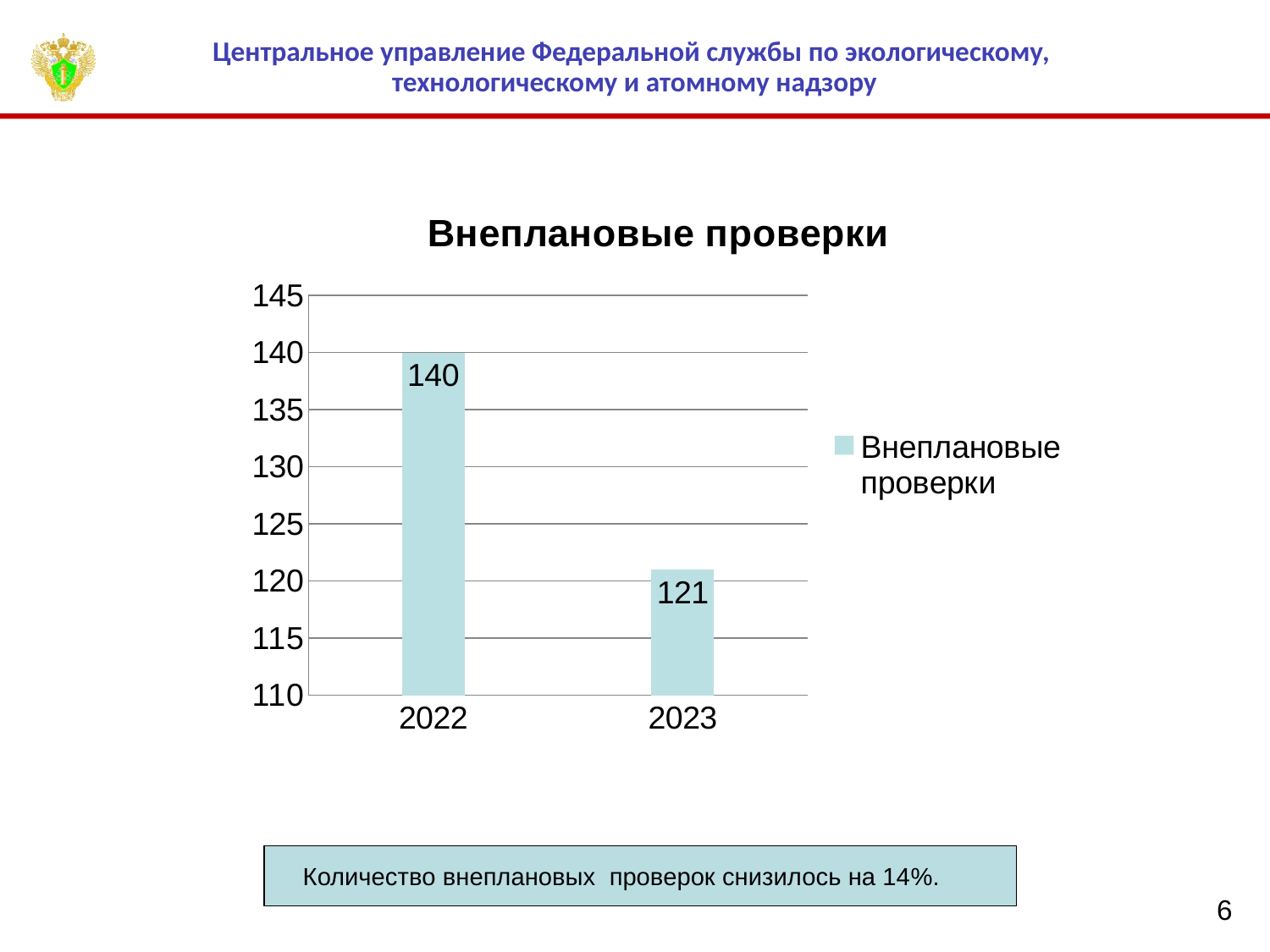
What is the value for 2023? 121 What is the difference between the values for 2022 and 2023? 19 Is the value for 2023 greater or less than 125? less Which year has the highest value? 2022 Which is larger, the value for 2022 or the value for 2023? 2022 Do the values rise or fall from 2022 to 2023? fall What kind of chart is shown? bar chart Which year has the lowest value? 2023 What is the title of the chart? Внеплановые проверки How many categories are shown on the x axis? 2 How many series does the legend list? 1 What is the value for 2022? 140